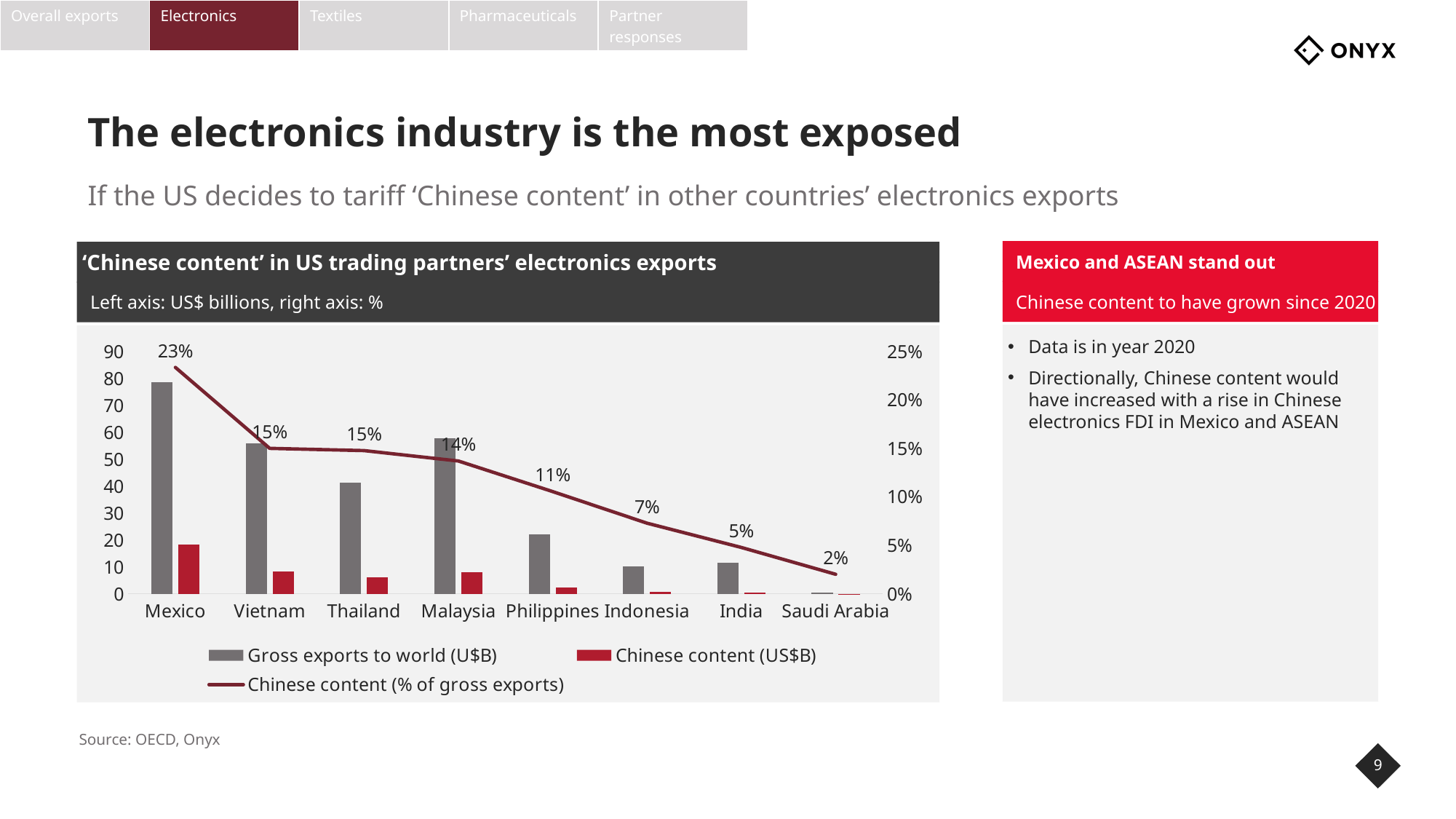
What is the Chinese content as a percentage of gross exports for Saudi Arabia? 2% Is the value of gross exports to world for Mexico greater or less than 70? greater Which country has the highest Chinese content as a percentage of gross exports? Mexico What is the Chinese content as a percentage of gross exports for Philippines? 11% How many countries are shown on the x axis? 8 Which country has larger gross exports to world, Vietnam or Thailand? Vietnam Is the value of gross exports to world for Indonesia greater or less than 20? less Does the Chinese content (% of gross exports) line rise or fall from Mexico to Saudi Arabia? Fall Which country has the lowest Chinese content as a percentage of gross exports? Saudi Arabia What is the Chinese content as a percentage of gross exports for Mexico? 23% How many percentage points higher is Mexico's Chinese content share than Vietnam's? 8 percentage points How many series does the legend list? 3